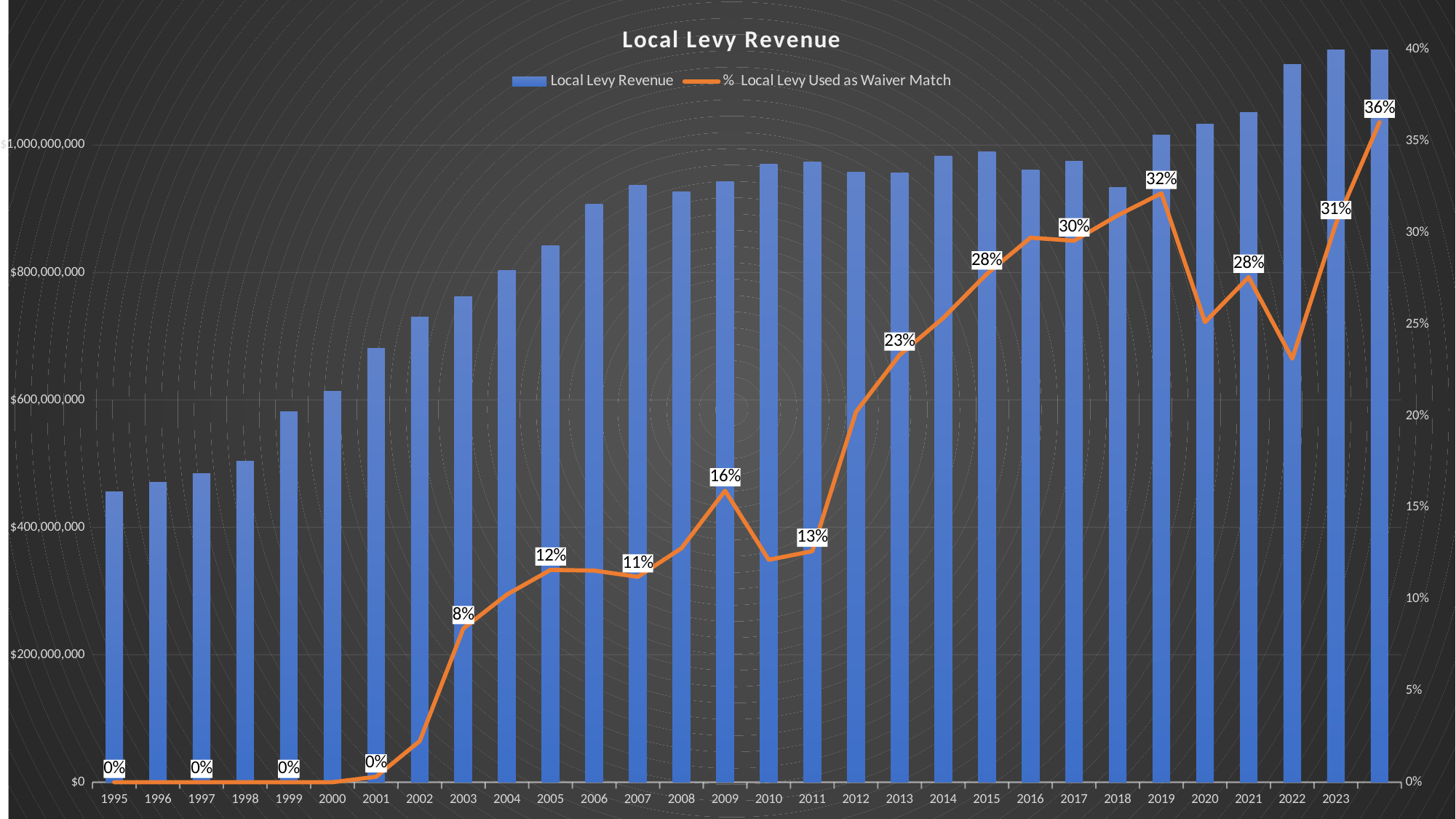
What percentage of local levy was used as waiver match in 2003? 8% Which year had a higher % Local Levy Used as Waiver Match, 2015 or 2017? 2017 What percentage of local levy was used as waiver match in 2013? 23% By how many percentage points did the % Local Levy Used as Waiver Match fall from 2019 to 2021? 4 percentage points What percentage of local levy was used as waiver match in 2019? 32% What kind of chart is shown on the slide? A combined bar and line chart What is the title of the chart? Local Levy Revenue What percentage of local levy was used as waiver match in 2009? 16% Is the Local Levy Revenue for 2023 greater or less than $1,000,000,000? greater How many series does the legend list? 2 What is the highest percentage labeled on the % Local Levy Used as Waiver Match line? 36% Is the Local Levy Revenue for 1995 greater or less than $600,000,000? less